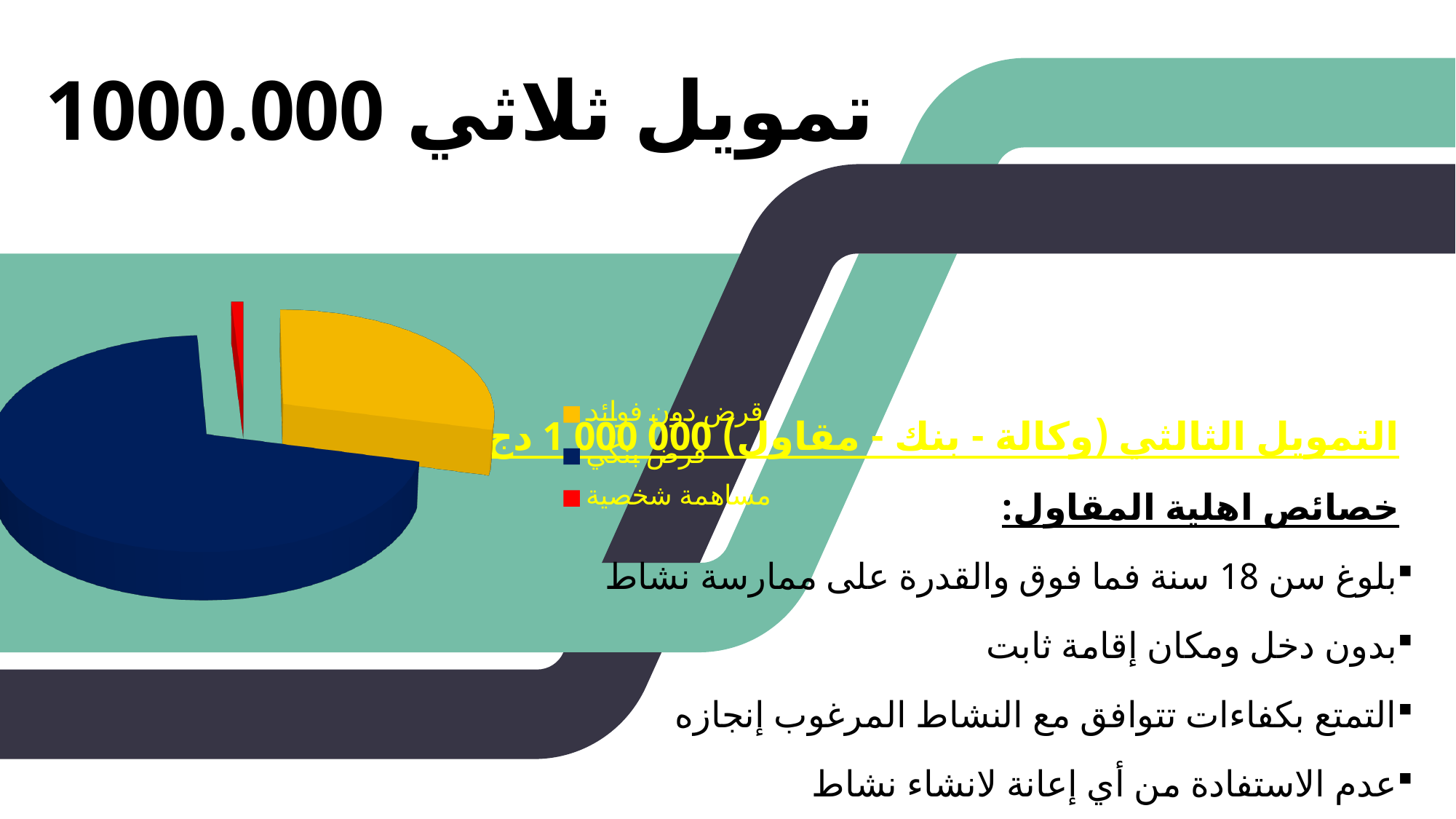
What colour is the slice for قرض دون فوائد in the pie chart? yellow Which slice is larger in the pie chart, قرض بنكي or قرض دون فوائد? قرض بنكي What kind of chart is shown on the slide? pie chart Which slice is larger in the pie chart, قرض دون فوائد or مساهمة شخصية? قرض دون فوائد Which category has the smallest slice in the pie chart? مساهمة شخصية What colour is the slice for مساهمة شخصية in the pie chart? red How many slices does the pie chart have? 3 Which category has the largest slice in the pie chart? قرض بنكي How many entries does the legend of the pie chart list? 3